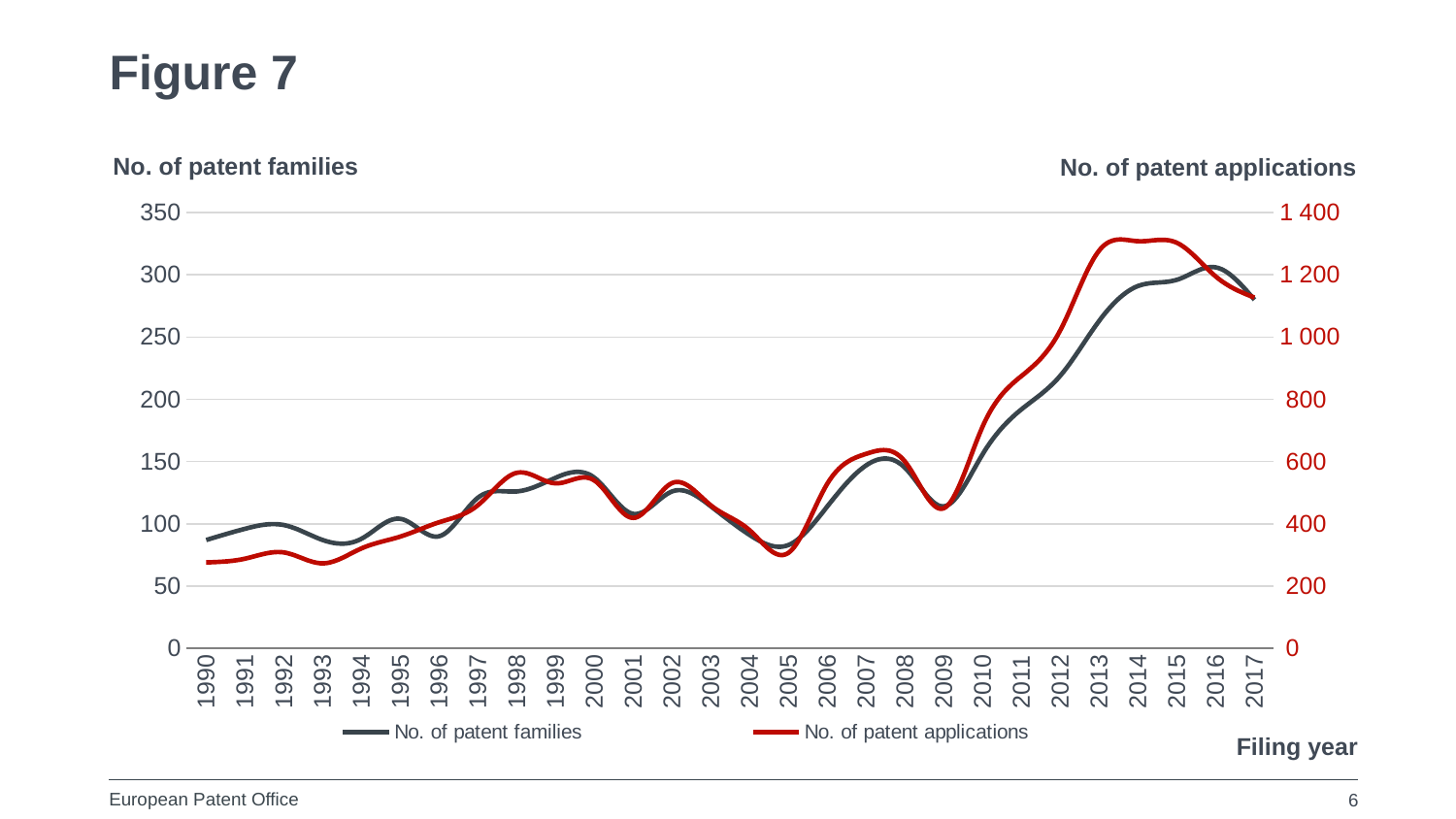
In which filing year does the No. of patent families series reach its highest value? 2016 Is the value for No. of patent families in 1990 greater or less than 100? less Is the value for No. of patent applications in 2013 greater or less than 1 200? greater How many series does the legend list? 2 Which series is plotted in red? No. of patent applications Is the value for No. of patent families in 2013 greater or less than 250? greater Do the values for No. of patent applications rise or fall between 2009 and 2013? rise What kind of chart is shown on the slide? line chart What is the label of the x axis? Filing year How many filing years are plotted along the x axis? 28